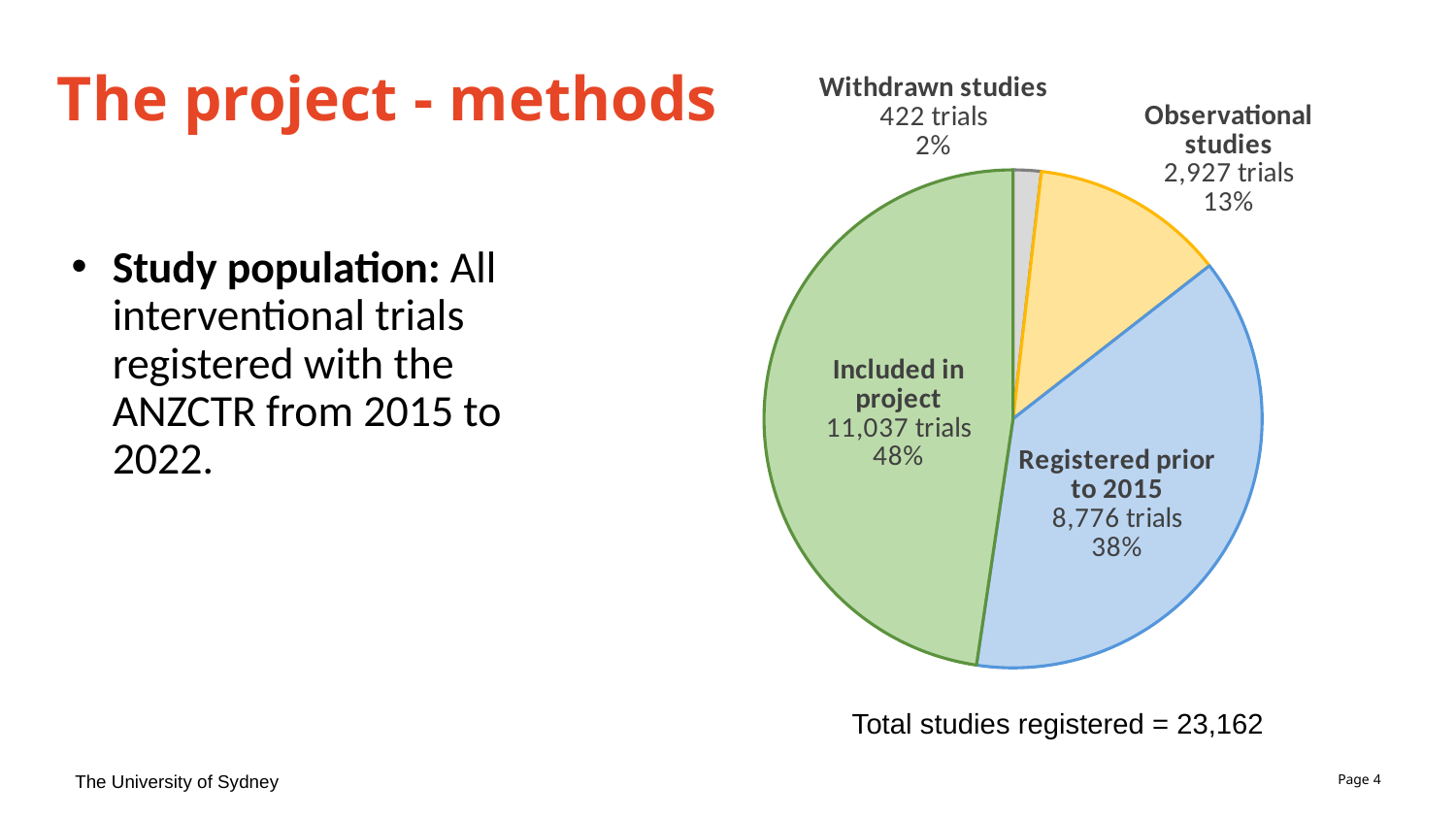
How many trials are in the 'Observational studies' slice? 2,927 trials What is the difference in number of trials between 'Included in project' and 'Registered prior to 2015'? 2,261 trials Which slice of the pie is the largest? Included in project Which has more trials: 'Observational studies' or 'Withdrawn studies'? Observational studies How many trials are in the 'Withdrawn studies' slice? 422 trials How many trials are in the 'Included in project' slice? 11,037 trials How many slices does the pie chart have? 4 What kind of chart is shown on the slide? pie chart Which slice of the pie is the smallest? Withdrawn studies What share of the pie do 'Observational studies' represent? 13% What share of the pie does 'Registered prior to 2015' represent? 38% How many trials are in the 'Registered prior to 2015' slice? 8,776 trials